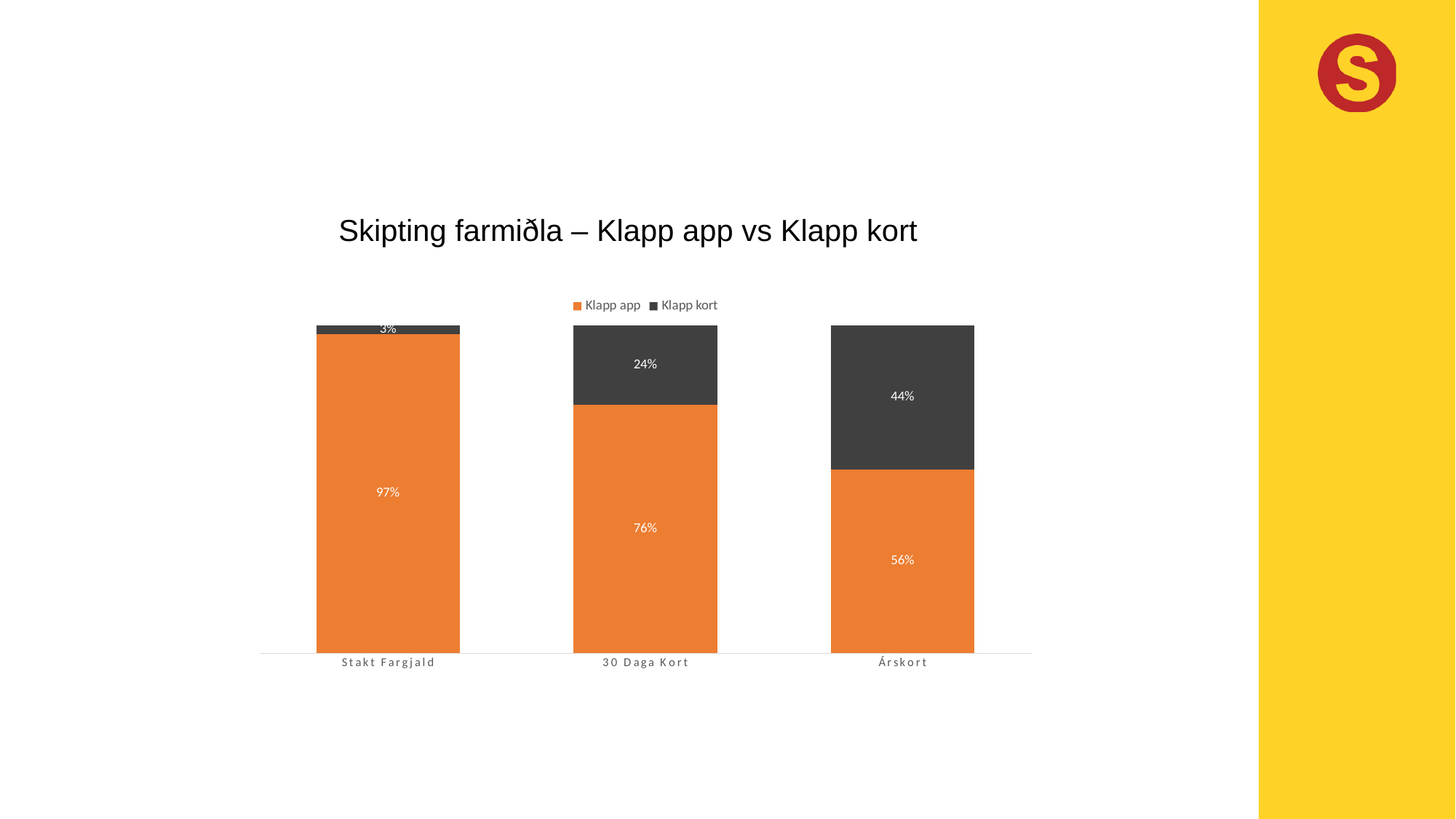
How many categories are shown on the x axis? 3 Which category has the highest Klapp kort share? Árskort Which category has the lowest Klapp app share? Árskort What is the Klapp kort value for Stakt Fargjald? 3% What is the difference between the Klapp app values for Stakt Fargjald and 30 Daga Kort? 21% How many series does the legend list? 2 What is the Klapp app value for Árskort? 56% What is the Klapp app value for Stakt Fargjald? 97% What is the Klapp kort value for 30 Daga Kort? 24% What kind of chart is shown on the slide? Stacked bar chart Does the Klapp app share rise or fall from Stakt Fargjald to Árskort? Fall Is the Klapp app value larger for 30 Daga Kort or for Árskort? 30 Daga Kort